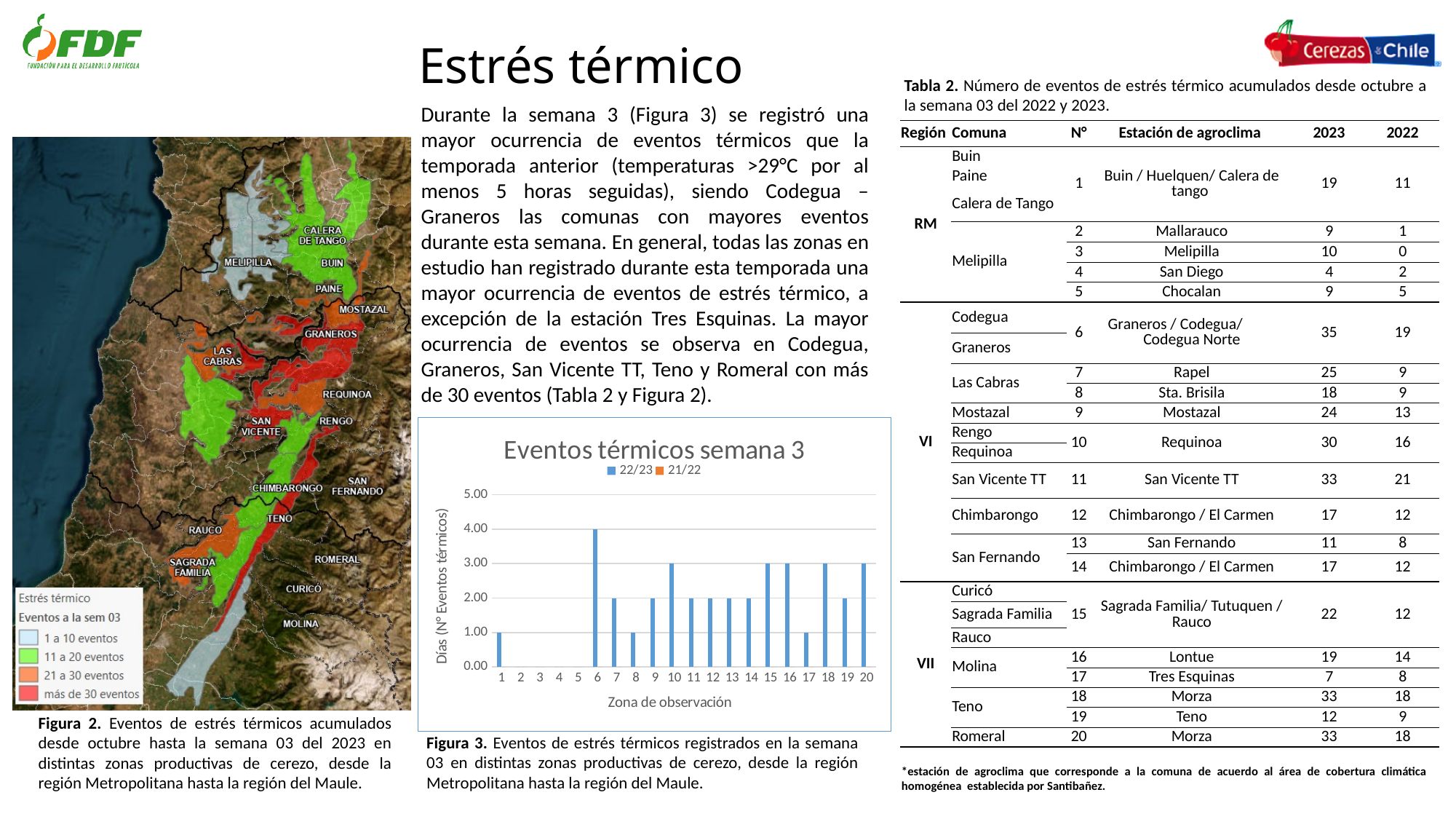
In the chart 'Eventos térmicos semana 3', which is larger for the 22/23 series: zone 6 or zone 7? zone 6 What is the title of the chart on the slide? Eventos térmicos semana 3 In the chart 'Eventos térmicos semana 3', which observation zone has the highest value for the 22/23 series? 6 In the chart 'Eventos térmicos semana 3', what is the value for zone 6 in the 22/23 series? 4.00 In the chart 'Eventos térmicos semana 3', what is the value for zone 10 in the 22/23 series? 3.00 What type of chart is 'Eventos térmicos semana 3'? bar chart In the chart 'Eventos térmicos semana 3', what is the value for zone 1 in the 22/23 series? 1.00 In the chart 'Eventos térmicos semana 3', is the 22/23 value for zone 6 greater or less than 3.00? greater What are the two series named in the legend of the chart 'Eventos térmicos semana 3'? 22/23 and 21/22 How many observation zones are shown on the x axis of the chart 'Eventos térmicos semana 3'? 20 In the chart 'Eventos térmicos semana 3', what is the difference between the 22/23 values for zone 6 and zone 1? 3.00 How many series does the legend of the chart 'Eventos térmicos semana 3' list? 2